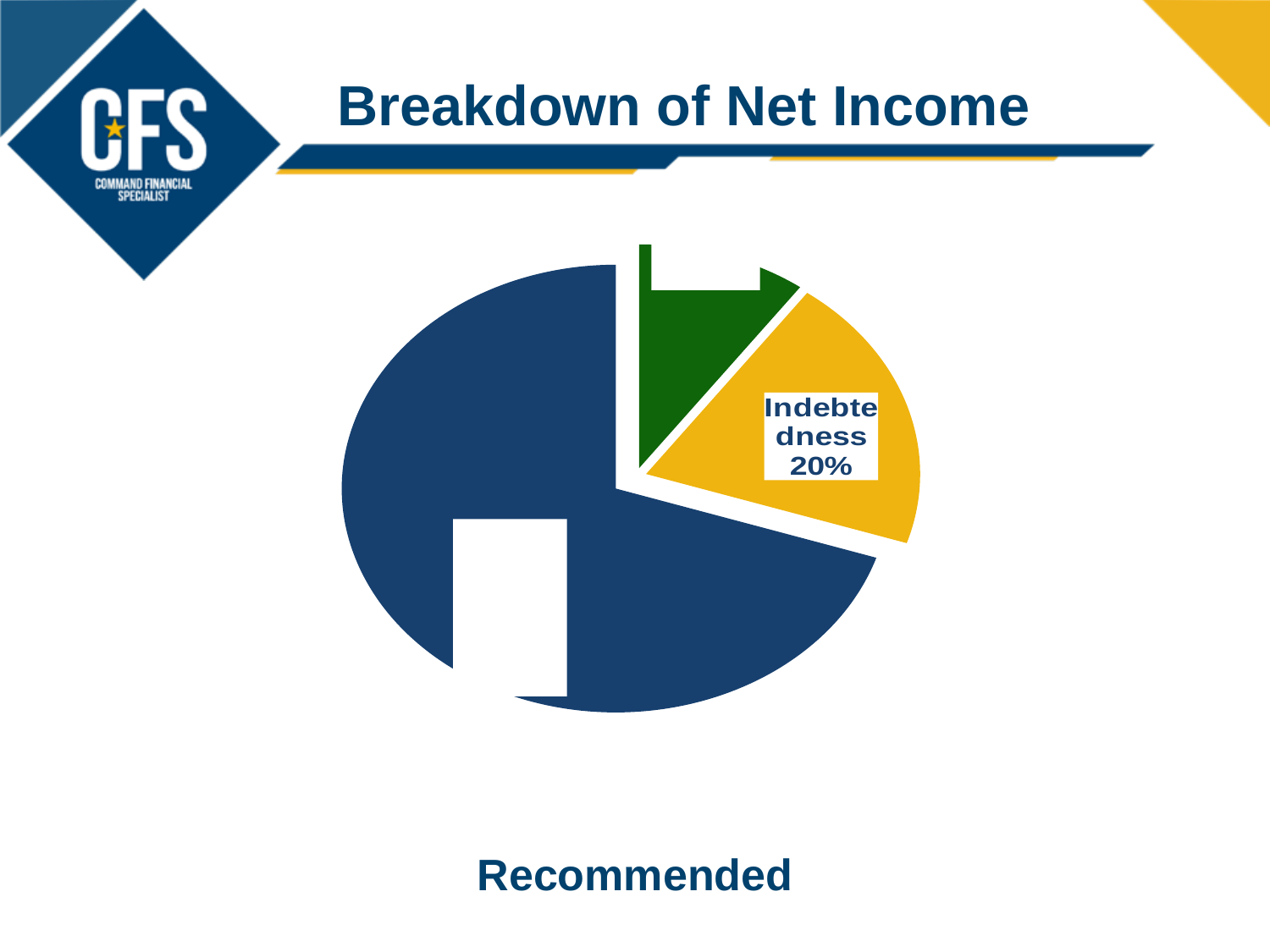
What word appears below the pie chart? Recommended What colour is the Indebtedness slice? yellow Which colour slice is the smallest in the pie chart? green Is the yellow Indebtedness slice larger or smaller than the green slice? larger How many slices does the pie chart have? 3 What is the title of the chart? Breakdown of Net Income Is the Indebtedness slice the largest slice of the pie? No What share of net income does the Indebtedness slice represent? 20% What type of chart is shown on the slide? pie chart Which colour slice is the largest in the pie chart? dark blue